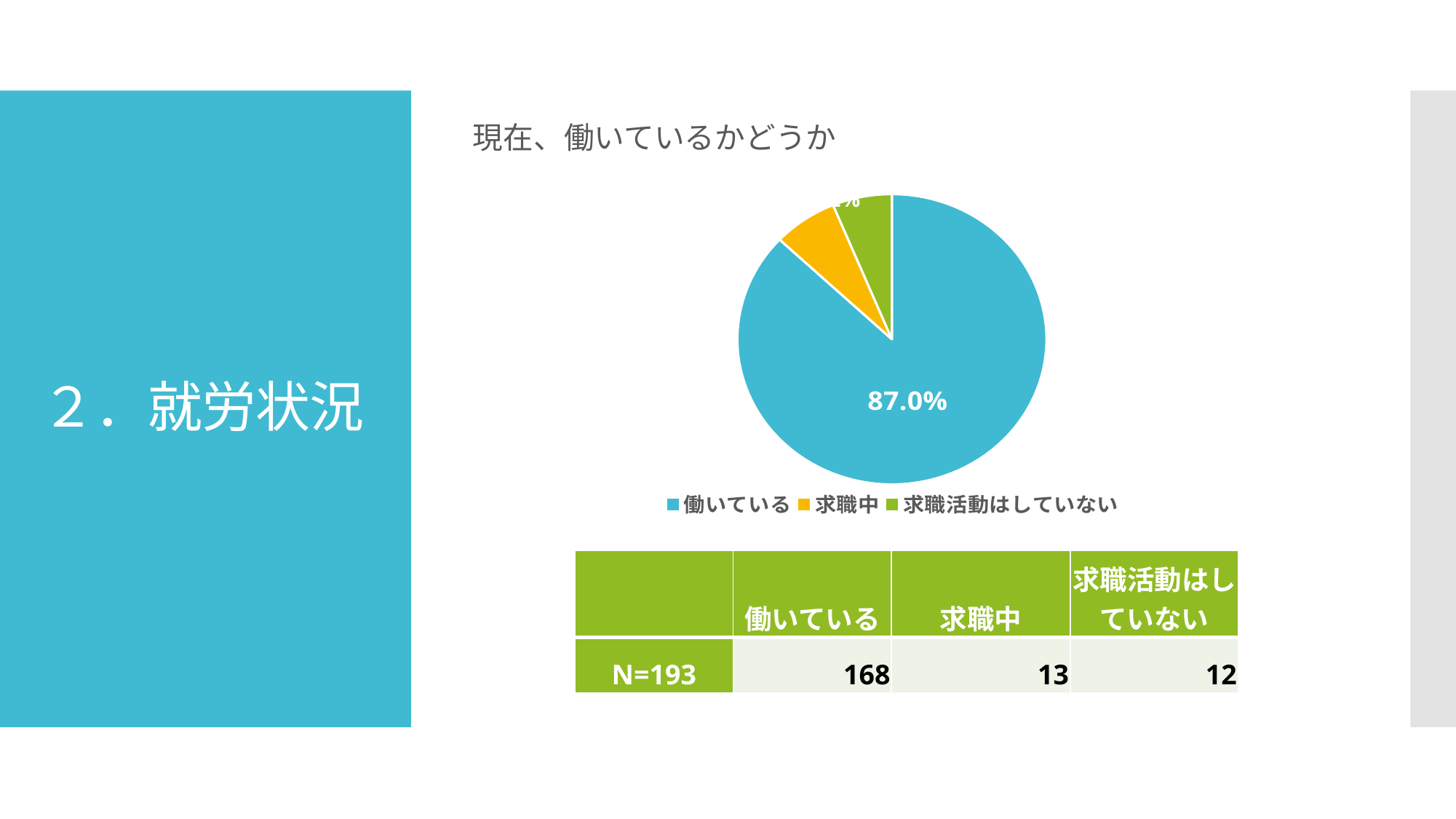
What share of the pie does 働いている account for? 87.0% What kind of chart is shown on the slide? pie chart According to the table below the chart, how many respondents answered 働いている? 168 How many entries does the legend list? 3 What is the total number of respondents (N) shown in the table? 193 What colour is the slice for 働いている? blue How many slices does the pie chart have? 3 According to the table below the chart, how many respondents answered 求職中? 13 According to the table below the chart, how many respondents answered 求職活動はしていない? 12 What is the title of the chart? 現在、働いているかどうか Which category has the largest slice of the pie? 働いている Which is larger, the slice for 働いている or the slice for 求職中? 働いている